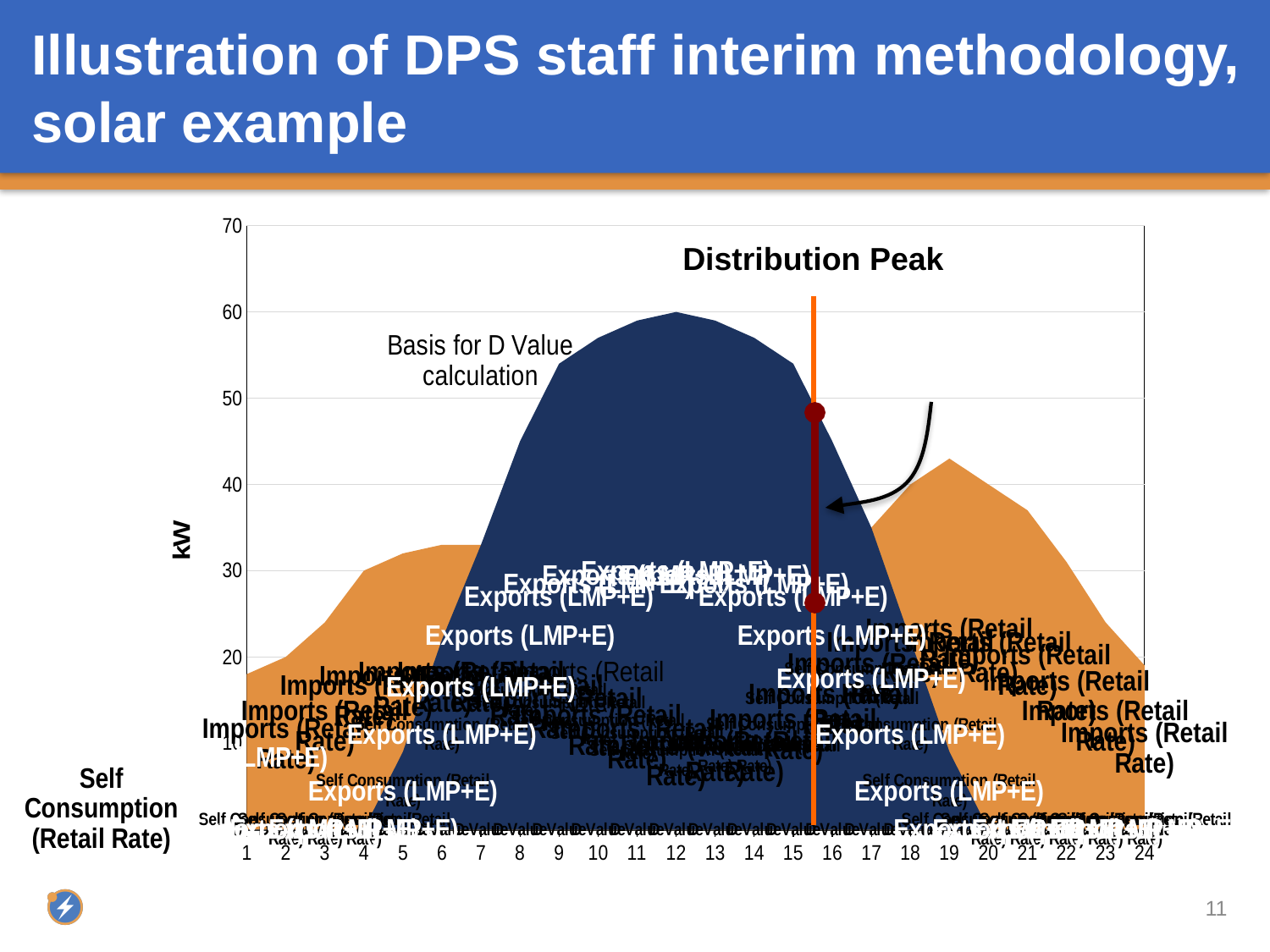
Which is larger at hour 12: the dark blue (Exports) area or the orange area at hour 1? the dark blue (Exports) area at hour 12 Is the value of the orange area at hour 3 greater or less than 30? less What is the label on the vertical axis of the chart? kW Does the dark blue (Exports) area rise or fall between hour 7 and hour 12? rise How many hourly categories are shown along the x axis of the chart? 24 Does the orange area rise or fall between hour 19 and hour 24? fall What does the vertical red line on the chart mark, according to the annotation above it? Distribution Peak What kind of chart is shown on the slide? area chart Is the value of the dark blue (Exports) area at hour 9 greater or less than 40? greater Is the value of the orange area at hour 6 greater or less than 30? greater